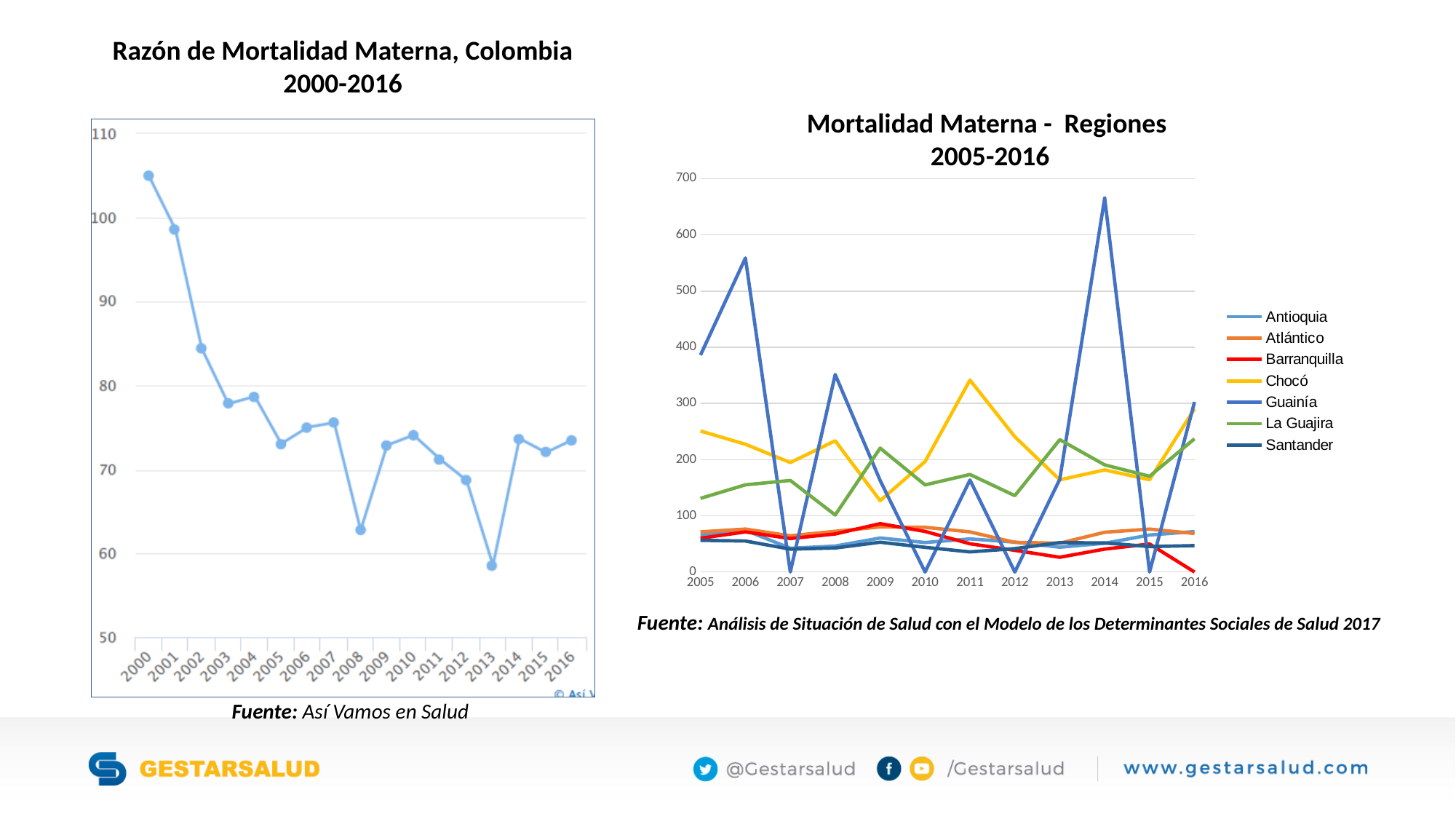
In the 'Razón de Mortalidad Materna, Colombia 2000-2016' chart, how many years are plotted on the x axis? 17 In the 'Razón de Mortalidad Materna, Colombia 2000-2016' chart, is the value for 2008 greater or less than 70? less In the 'Razón de Mortalidad Materna, Colombia 2000-2016' chart, is the value for 2001 larger or smaller than the value for 2002? Larger In the 'Mortalidad Materna - Regiones 2005-2016' chart, which colour is used for the Chocó series? Yellow In the 'Razón de Mortalidad Materna, Colombia 2000-2016' chart, is the value for 2000 greater or less than 100? greater In the 'Mortalidad Materna - Regiones 2005-2016' chart, which region has the highest value in 2011? Chocó In the 'Razón de Mortalidad Materna, Colombia 2000-2016' chart, which year has the highest value? 2000 In the 'Mortalidad Materna - Regiones 2005-2016' chart, is the value for Guainía in 2014 greater or less than 600? greater In the 'Razón de Mortalidad Materna, Colombia 2000-2016' chart, which year has the lowest value? 2013 How many series does the legend of the 'Mortalidad Materna - Regiones 2005-2016' chart list? 7 What kind of chart is the 'Razón de Mortalidad Materna, Colombia 2000-2016' chart on the left? Line chart In the 'Razón de Mortalidad Materna, Colombia 2000-2016' chart, do the values generally rise or fall from 2000 to 2003? Fall